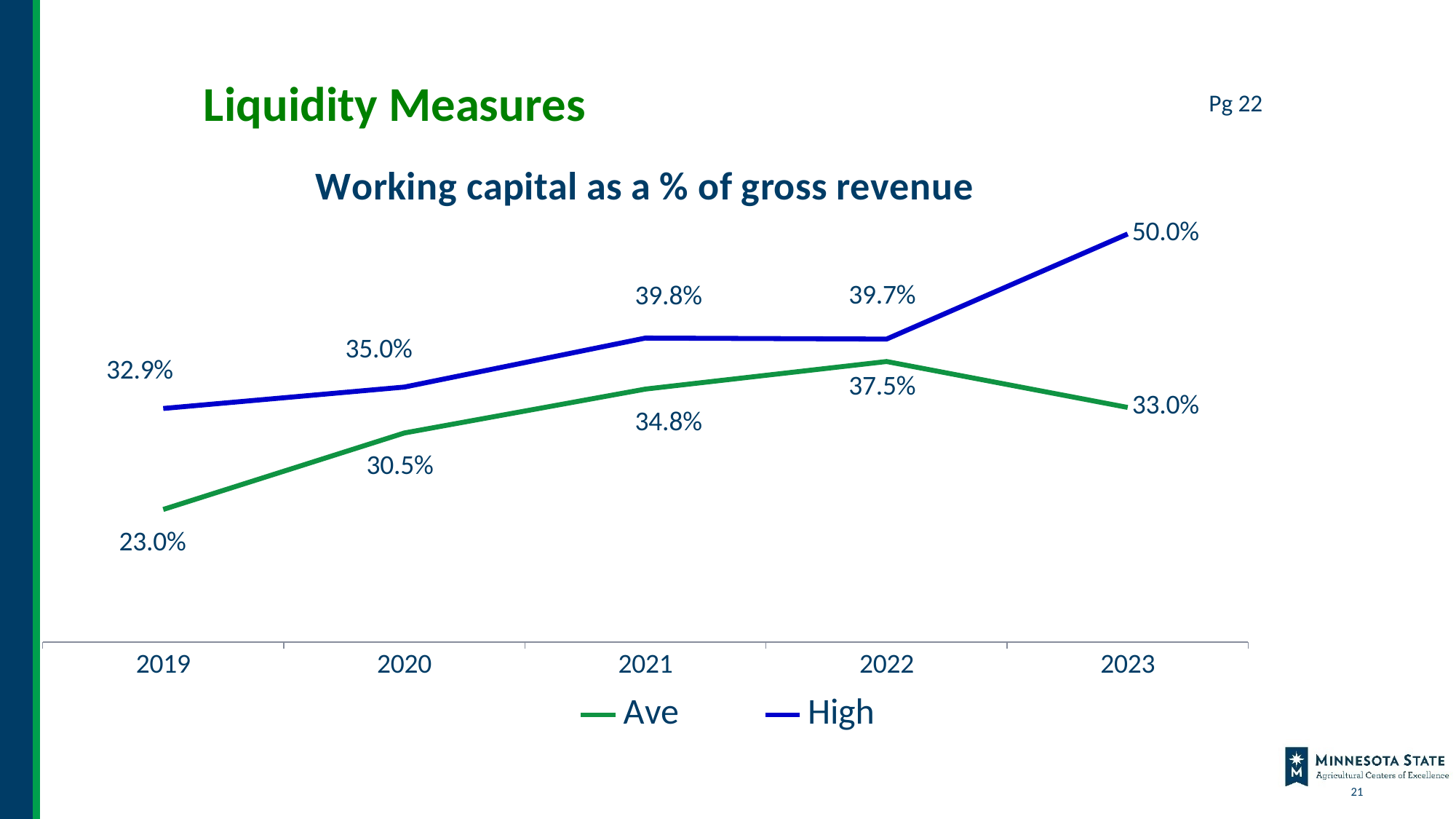
What is the Ave value for 2019? 23.0% What is the High value for 2020? 35.0% What is the difference between the High and Ave values in 2023? 17.0% In which year is the Ave series highest? 2022 What is the High value for 2023? 50.0% What kind of chart is this? line chart Which is larger, the Ave value in 2021 or the Ave value in 2023? 2021 How many series does the legend list? 2 What is the Ave value for 2022? 37.5% What is the title of the chart? Working capital as a % of gross revenue How many years are shown on the x axis? 5 In which year is the High series lowest? 2019